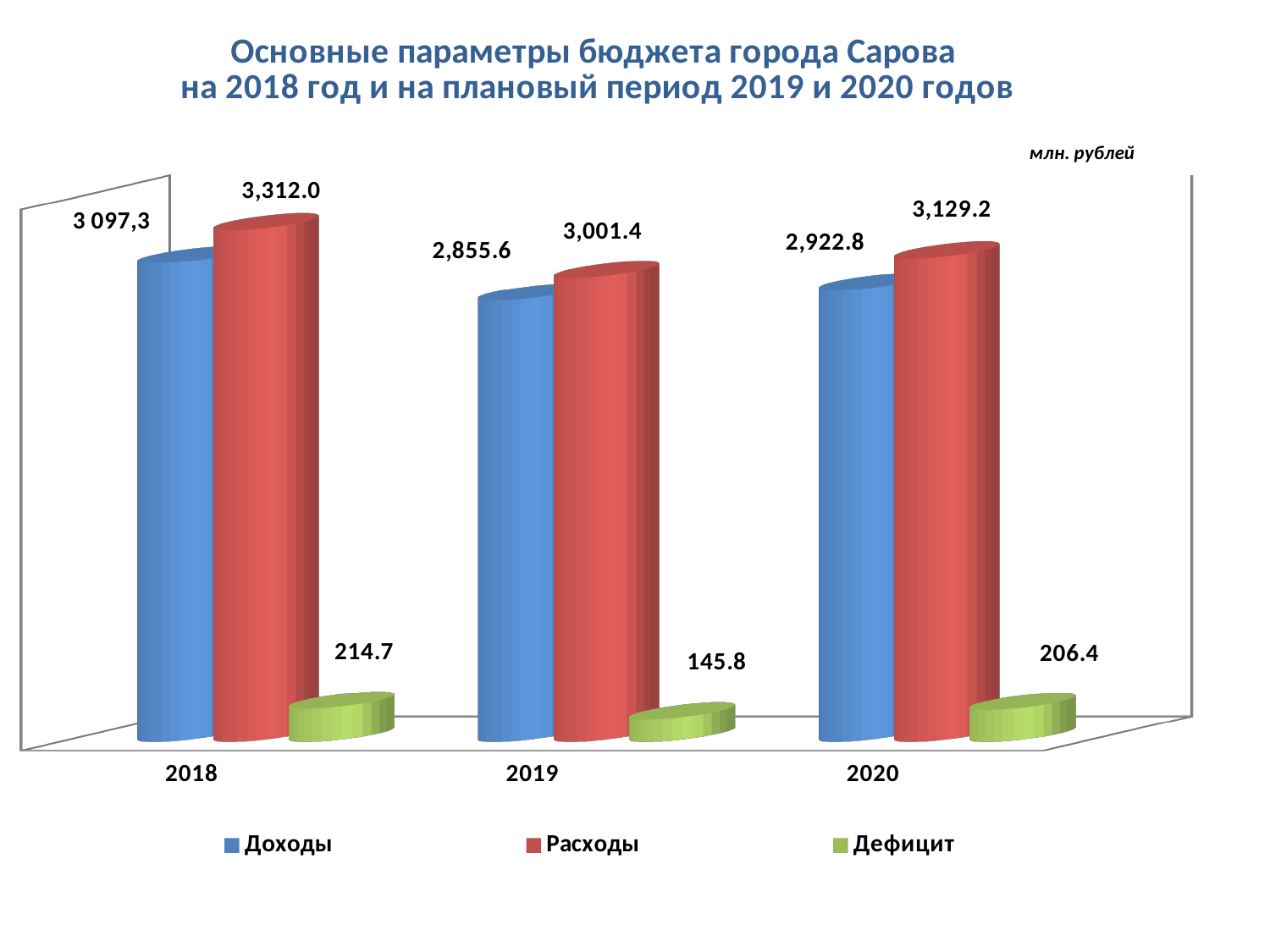
Which is larger in 2020: Доходы or Расходы? Расходы What is the difference between Расходы in 2018 and Расходы in 2019? 310.6 In which year is Дефицит lowest? 2019 How many years are shown on the x axis? 3 In which year is Расходы highest? 2018 What is the value of Доходы for 2018? 3 097,3 How many series does the legend list? 3 What is the difference between Расходы and Доходы in 2019? 145.8 What is the value of Дефицит for 2020? 206.4 What is the value of Доходы for 2020? 2,922.8 What is the value of Расходы for 2019? 3,001.4 What kind of chart is shown on the slide? Bar chart